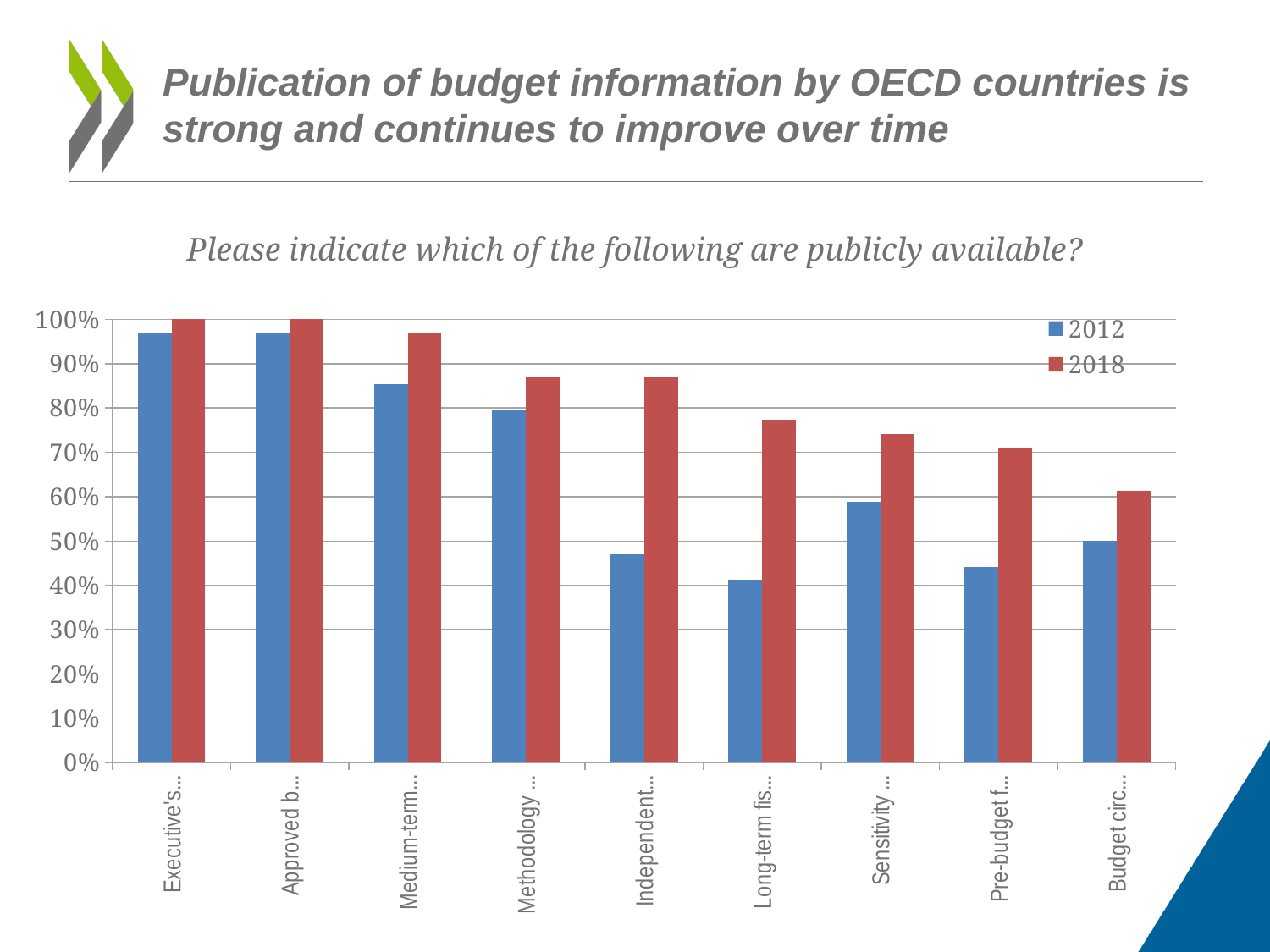
Which category has the lowest 2018 value? Budget circ... How many categories are plotted along the x axis of the chart? 9 Which colour represents the 2018 series in the chart? red Is the 2018 value for the category labelled "Independent..." greater or less than 80%? greater Which is larger: the 2012 value for "Sensitivity ..." or the 2012 value for "Independent..."? Sensitivity ... Do the 2018 values generally rise or fall moving from left to right along the x axis? fall What kind of chart is shown on the slide? bar chart Is the 2012 value for the category labelled "Long-term fis..." greater or less than 50%? less What is the 2018 value for the category labelled "Executive's..."? 100% What is the 2018 value for the category labelled "Approved b..."? 100% How many series does the chart legend list? 2 Is the 2018 value for the category labelled "Sensitivity ..." greater or less than 70%? greater